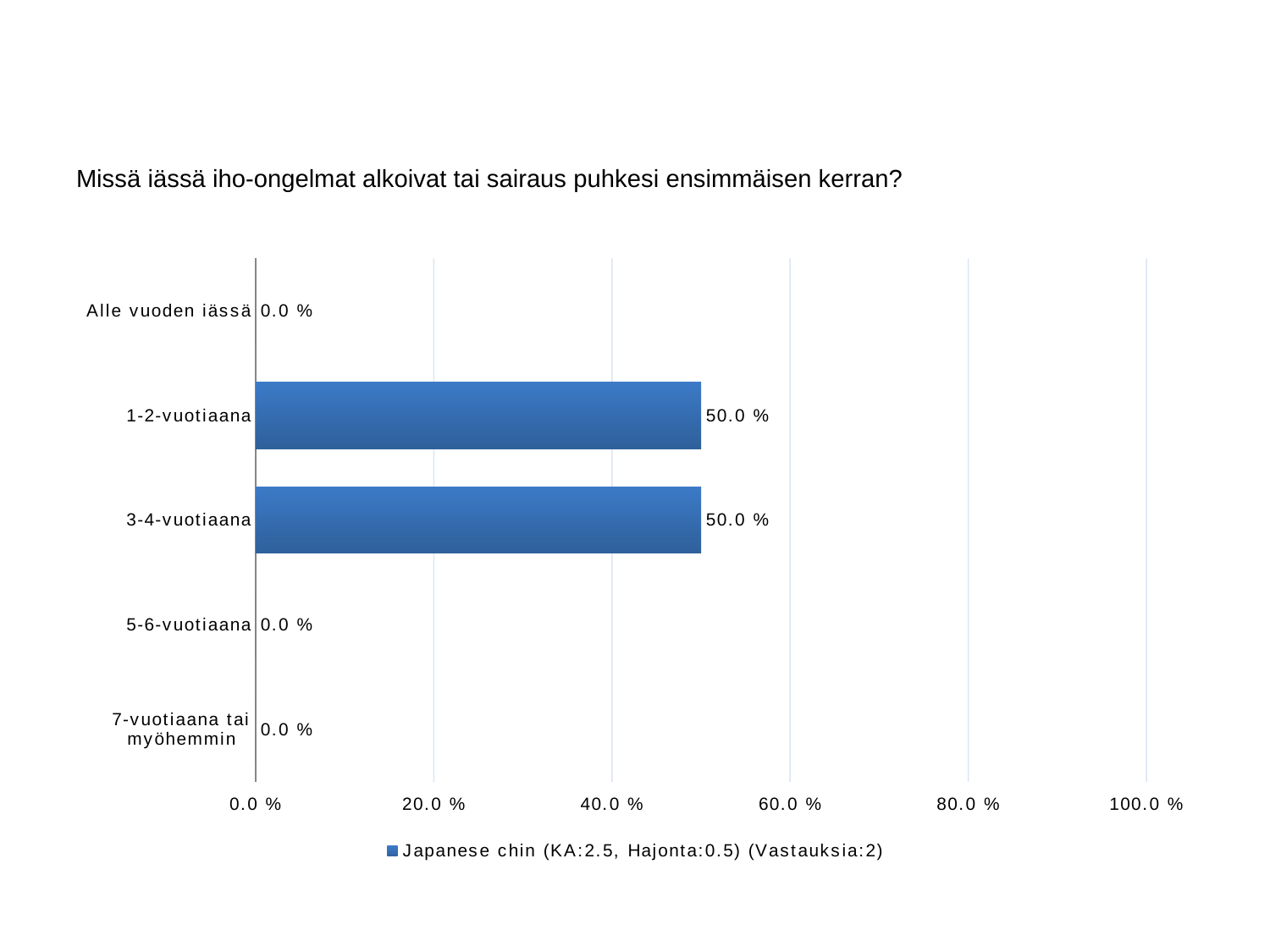
How many series does the legend list? 1 What is the difference between the values for 1-2-vuotiaana and 5-6-vuotiaana? 50.0 % What is the value for 1-2-vuotiaana? 50.0 % What is the value for Alle vuoden iässä? 0.0 % What is the legend entry for the series shown? Japanese chin (KA:2.5, Hajonta:0.5) (Vastauksia:2) What is the value for 5-6-vuotiaana? 0.0 % What is the value for 3-4-vuotiaana? 50.0 % What is the value for 7-vuotiaana tai myöhemmin? 0.0 % What kind of chart is shown on the slide? bar chart Is the value for 1-2-vuotiaana greater or less than 40.0 %? greater How many categories are shown on the chart? 5 Which is larger, the value for 3-4-vuotiaana or the value for Alle vuoden iässä? 3-4-vuotiaana